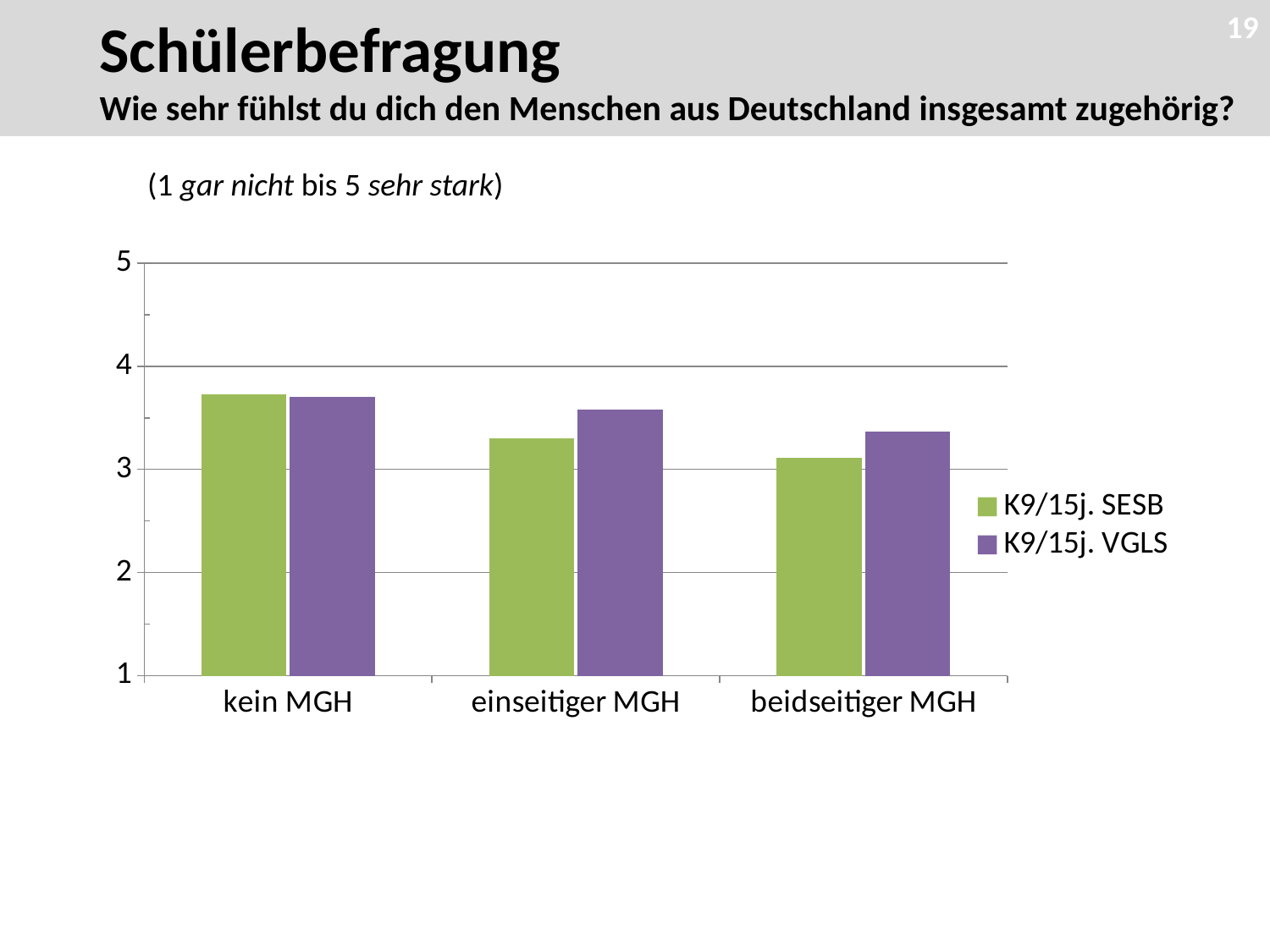
Which series does the purple bar represent? K9/15j. VGLS For the K9/15j. SESB series, which category has the lowest value? beidseitiger MGH What kind of chart is shown on the slide? bar chart Is the value for K9/15j. SESB at beidseitiger MGH greater or less than 3? greater Which series does the green bar represent? K9/15j. SESB How many categories are shown on the x axis of the chart? 3 Is the value for K9/15j. SESB at einseitiger MGH greater or less than 4? less At einseitiger MGH, which series has the larger value, K9/15j. SESB or K9/15j. VGLS? K9/15j. VGLS Do the values for K9/15j. SESB rise or fall from kein MGH to beidseitiger MGH? fall Is the value for K9/15j. VGLS at kein MGH greater or less than 4? less How many series does the chart's legend list? 2 At beidseitiger MGH, which series has the larger value, K9/15j. SESB or K9/15j. VGLS? K9/15j. VGLS